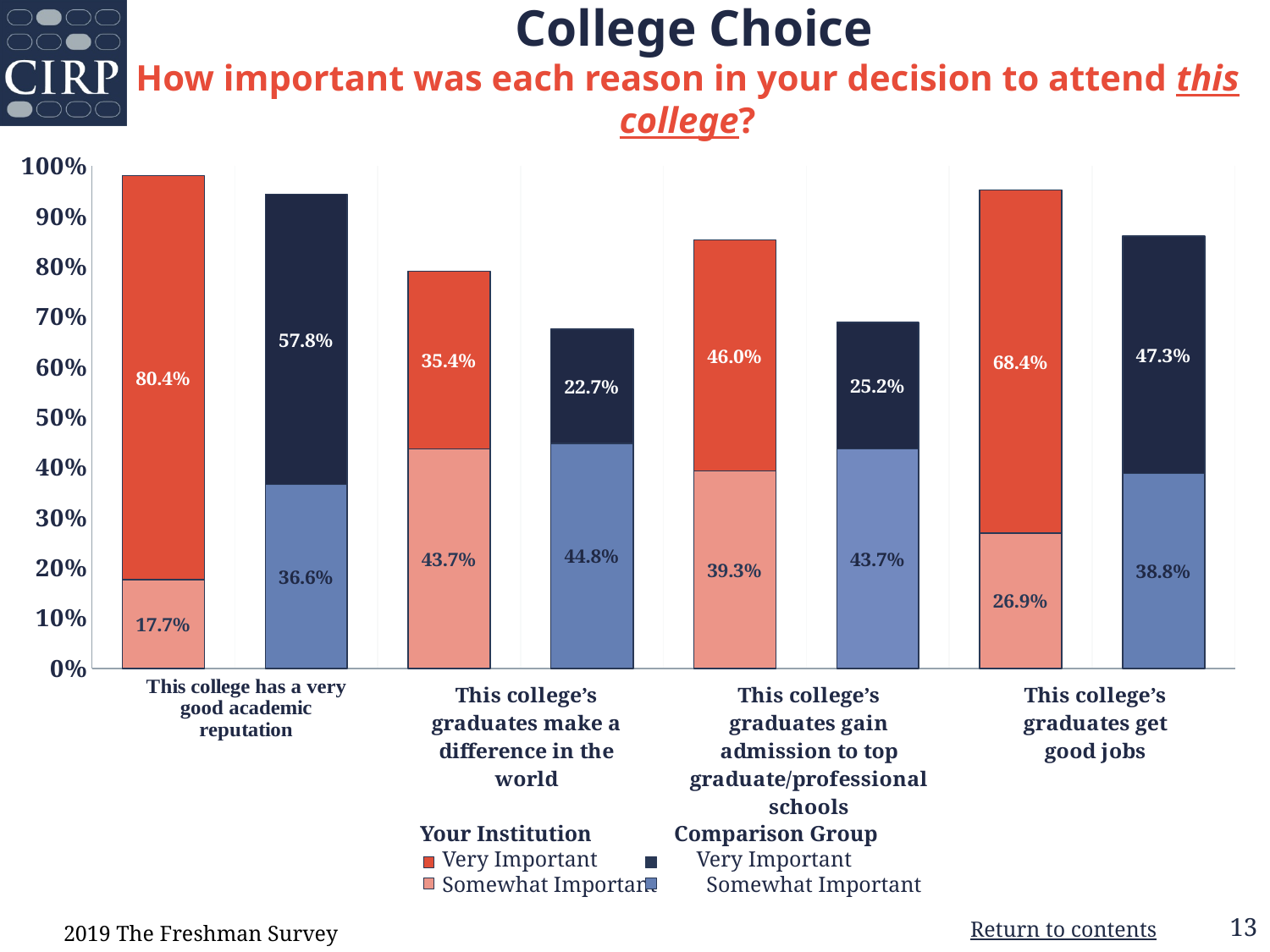
What is the Very Important percentage for the Comparison Group on "This college's graduates gain admission to top graduate/professional schools"? 25.2% Which reason has the highest Very Important percentage for Your Institution? This college has a very good academic reputation What is the difference between the Your Institution and Comparison Group Very Important percentages for "This college's graduates get good jobs"? 21.1% How many reasons (categories) are shown on the x axis? 4 For "This college's graduates make a difference in the world", is the Somewhat Important percentage larger for Your Institution or the Comparison Group? Comparison Group What is the total (Very Important plus Somewhat Important) for Your Institution on "This college's graduates gain admission to top graduate/professional schools"? 85.3% What is the total (Very Important plus Somewhat Important) for the Comparison Group on "This college has a very good academic reputation"? 94.4% Which reason has the lowest Very Important percentage for the Comparison Group? This college's graduates make a difference in the world What percentage of Your Institution respondents rated "This college has a very good academic reputation" as Very Important? 80.4% What percentage of the Comparison Group rated "This college's graduates get good jobs" as Somewhat Important? 38.8% What kind of chart is shown on the slide? Stacked bar chart How many series does the legend list? 4